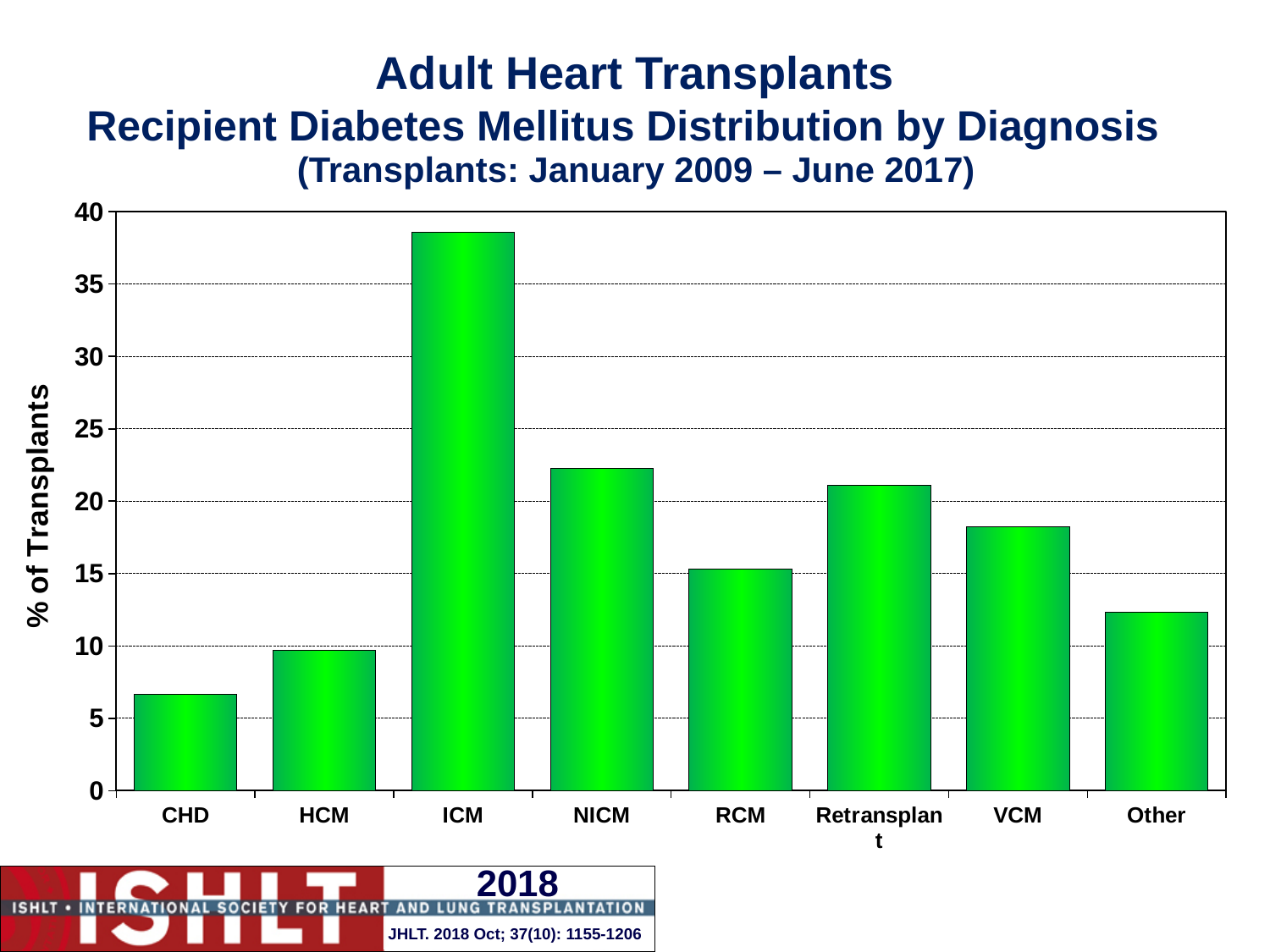
Which has a larger % of transplants, ICM or NICM? ICM Is the value for Other greater or less than 15? less What kind of chart is shown on the slide? bar chart How many diagnosis categories are shown on the x axis? 8 Is the value for ICM greater or less than 35? greater Which diagnosis category has the lowest % of transplants? CHD Which diagnosis category has the highest % of transplants? ICM What is the label of the y axis? % of Transplants Which has a larger % of transplants, VCM or RCM? VCM Is the value for CHD greater or less than 10? less